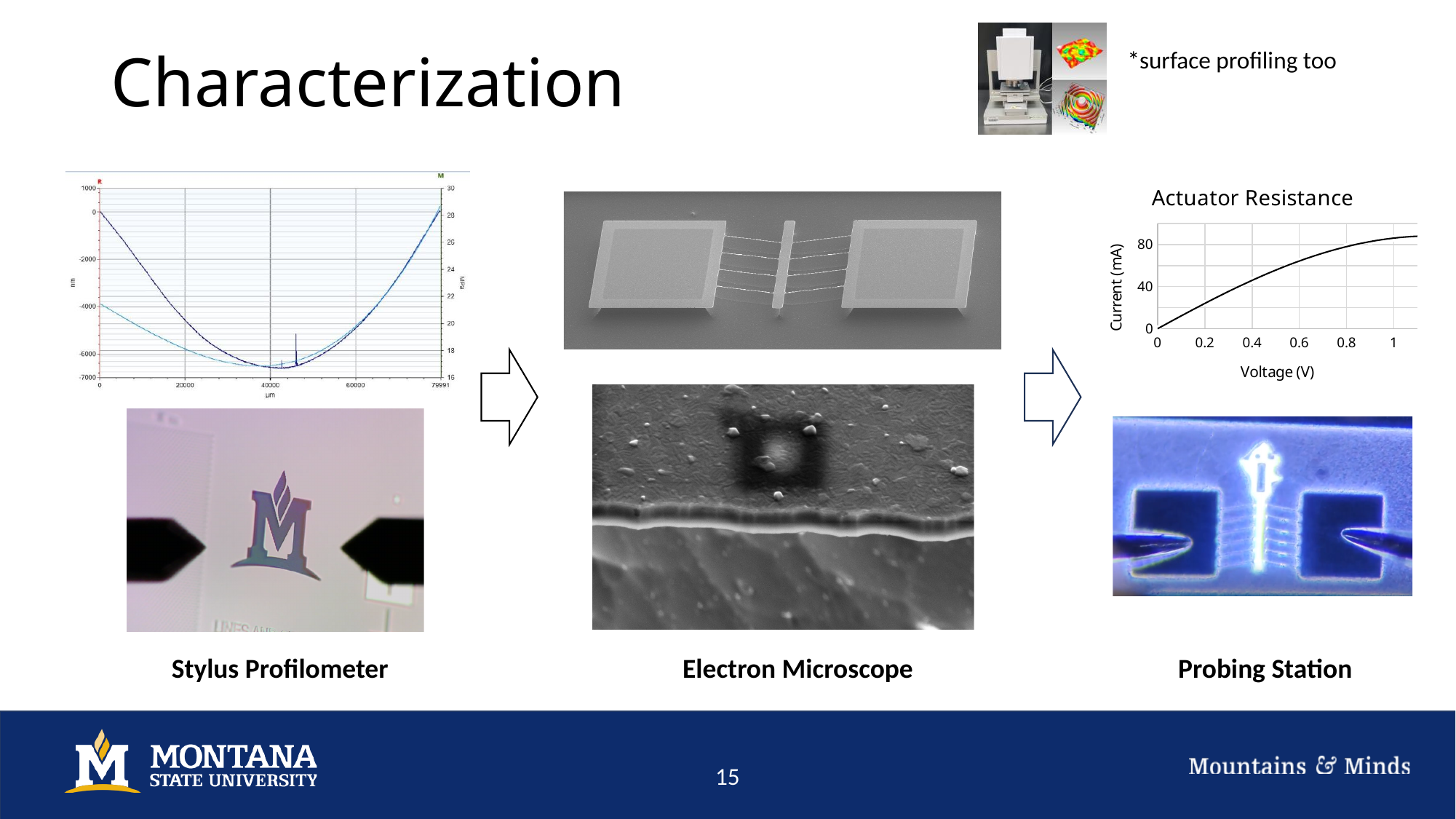
What kind of chart is the stylus profilometer plot on the left of the slide? line chart What kind of chart is the Actuator Resistance chart? line chart In the stylus profilometer chart on the left, what is the largest x-axis tick label shown? 79991 In the Actuator Resistance chart, is the current at 0.2 V greater or less than 40 mA? less How many tick labels are shown on the x axis of the Actuator Resistance chart? 6 How many curves are plotted in the stylus profilometer chart on the left of the slide? 2 In the Actuator Resistance chart, does the current rise or fall as voltage increases? rise What is the y-axis label of the Actuator Resistance chart? Current (mA) In the Actuator Resistance chart, is the current at 0.6 V greater or less than 80 mA? less What is the x-axis label of the Actuator Resistance chart? Voltage (V) In the Actuator Resistance chart, is the current at 1 V greater or less than 80 mA? greater